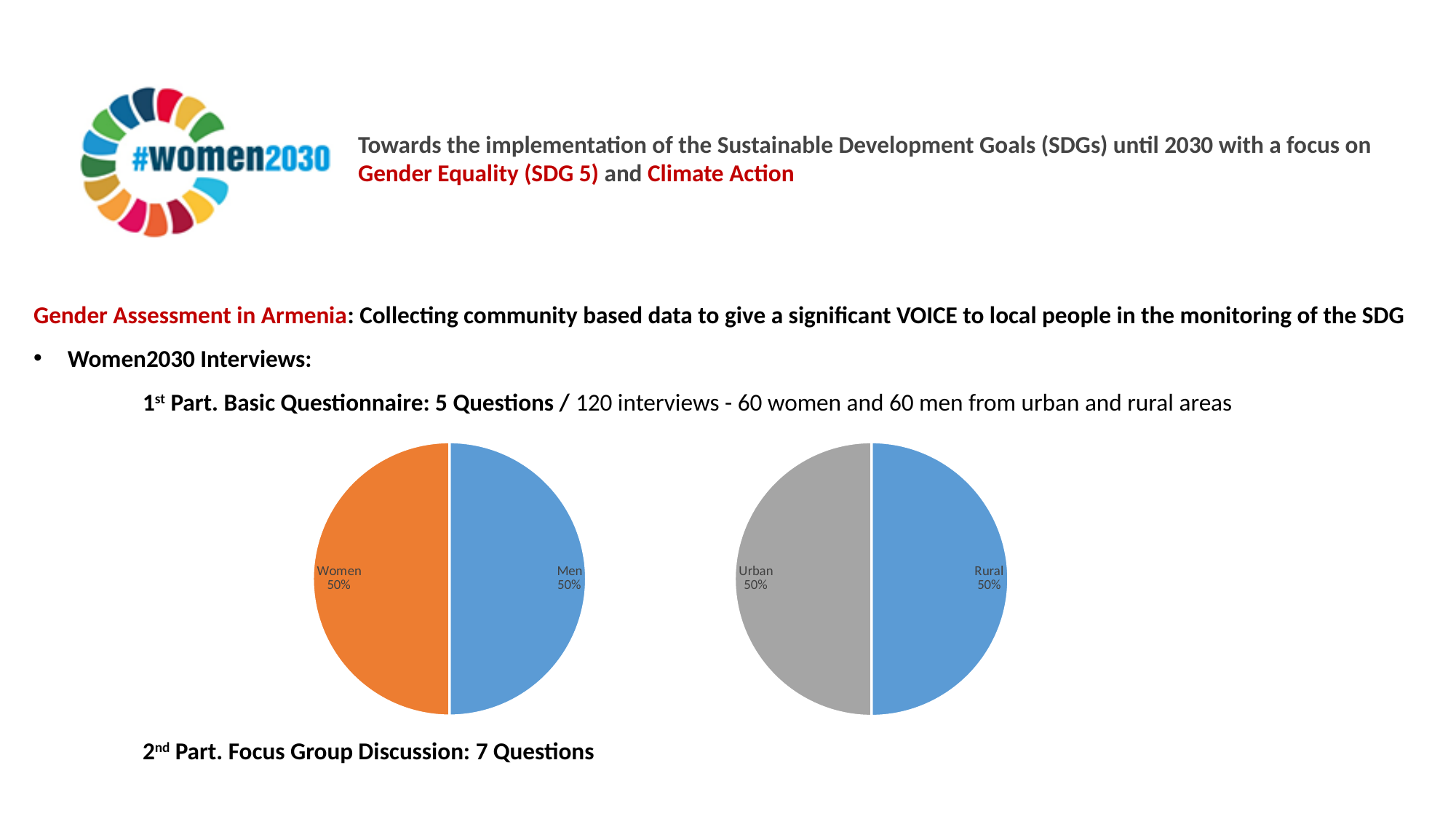
In the right pie chart, what share is labelled for Rural? 50% How many slices does the right pie chart have? 2 In the right pie chart, what share is labelled for Urban? 50% In the right pie chart, what is the difference between the Urban share and the Rural share? 0% What kind of chart is the right chart on the slide? Pie chart In the right pie chart, what colour is the Urban slice? Grey What kind of chart is the left chart on the slide? Pie chart In the left pie chart, what share is labelled for Men? 50% In the left pie chart, what is the difference between the Women share and the Men share? 0% How many slices does the left pie chart have? 2 In the left pie chart, what share is labelled for Women? 50% In the left pie chart, what colour is the Women slice? Orange